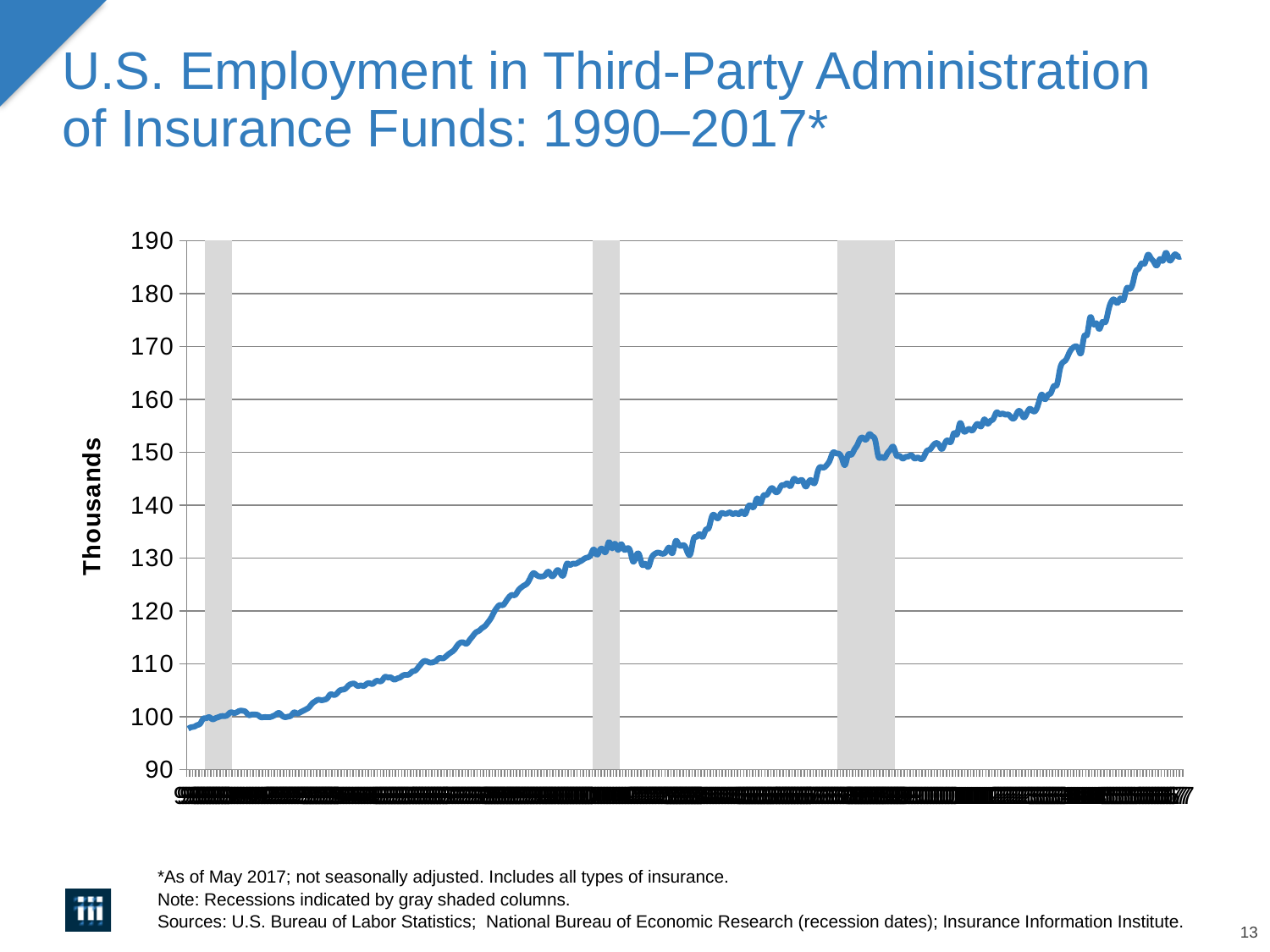
Is the value at the left-hand start of the line greater or less than 100? less Does the line reach its lowest value near the start or near the end of the period? Near the start Is the value at the right-hand end of the line greater or less than 180? greater How many gray shaded columns (recessions) appear on the chart? 3 Is the value at the end of the line higher or lower than the value at the start? Higher What is the label on the vertical axis? Thousands Is the highest point reached by the line greater or less than 190? less Overall, do the values rise or fall from the left to the right of the chart? Rise What kind of chart is shown on the slide? Line chart Does the line reach its highest value near the start or near the end of the period? Near the end